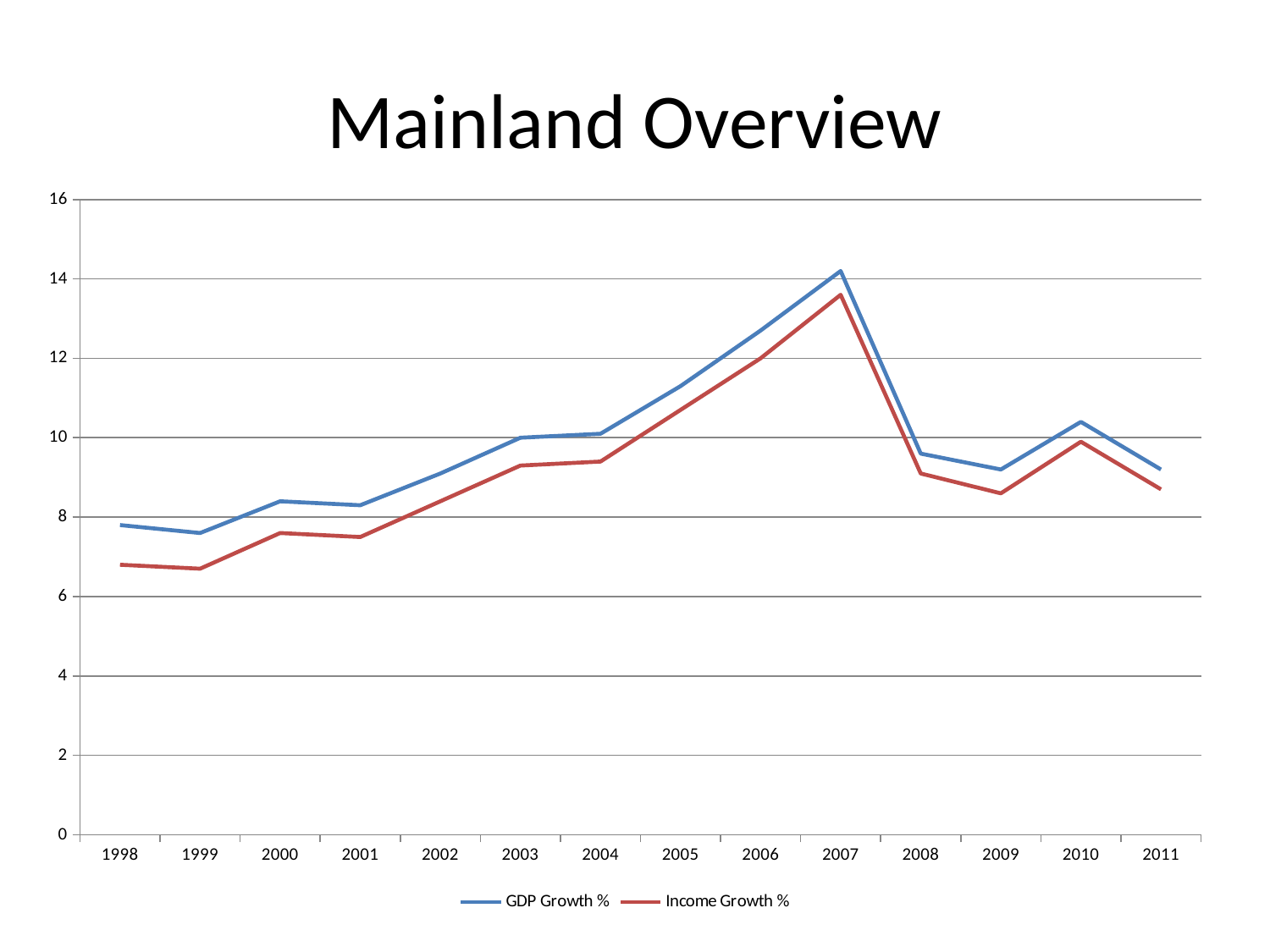
Is the value of Income Growth % in 1998 greater or less than 8? less Is the value of Income Growth % in 2009 greater or less than 10? less How many years are plotted along the x axis? 14 Is the value of GDP Growth % in 2007 greater or less than 12? greater Does GDP Growth % rise or fall between 2007 and 2008? fall In which year does GDP Growth % reach its highest value? 2007 How many series does the legend list? 2 In which year does Income Growth % reach its highest value? 2007 What is the title of the slide? Mainland Overview What kind of chart is shown on the slide? line chart Which series has the larger value in 2005, GDP Growth % or Income Growth %? GDP Growth % Does Income Growth % rise or fall between 2001 and 2007? rise